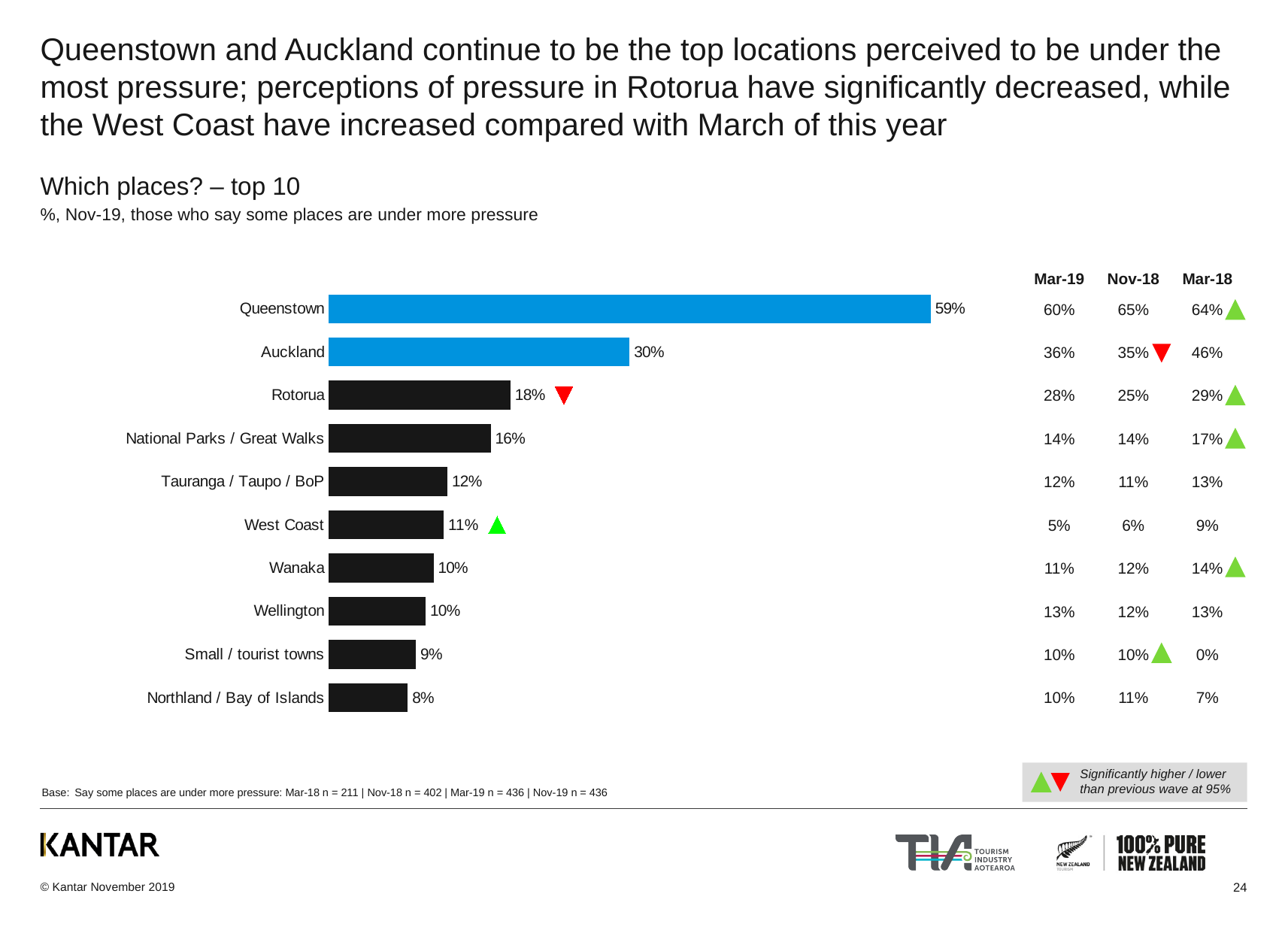
Which two bars in the chart are coloured blue rather than black? Queenstown and Auckland What is the difference between the Queenstown and Auckland values in the bar chart? 29 percentage points Which place has the lowest value in the bar chart? Northland / Bay of Islands What is the difference between the Tauranga / Taupo / BoP and Northland / Bay of Islands values in the bar chart? 4 percentage points What percentage is shown for West Coast in the bar chart? 11% Which has a larger value in the bar chart, Rotorua or National Parks / Great Walks? Rotorua What percentage is shown for Rotorua in the bar chart? 18% What type of chart is shown on the slide? Bar chart What is the subtitle of the chart? Which places? – top 10 How many places are shown in the bar chart? 10 What percentage is shown for Queenstown in the bar chart? 59% Which place has the highest value in the bar chart? Queenstown